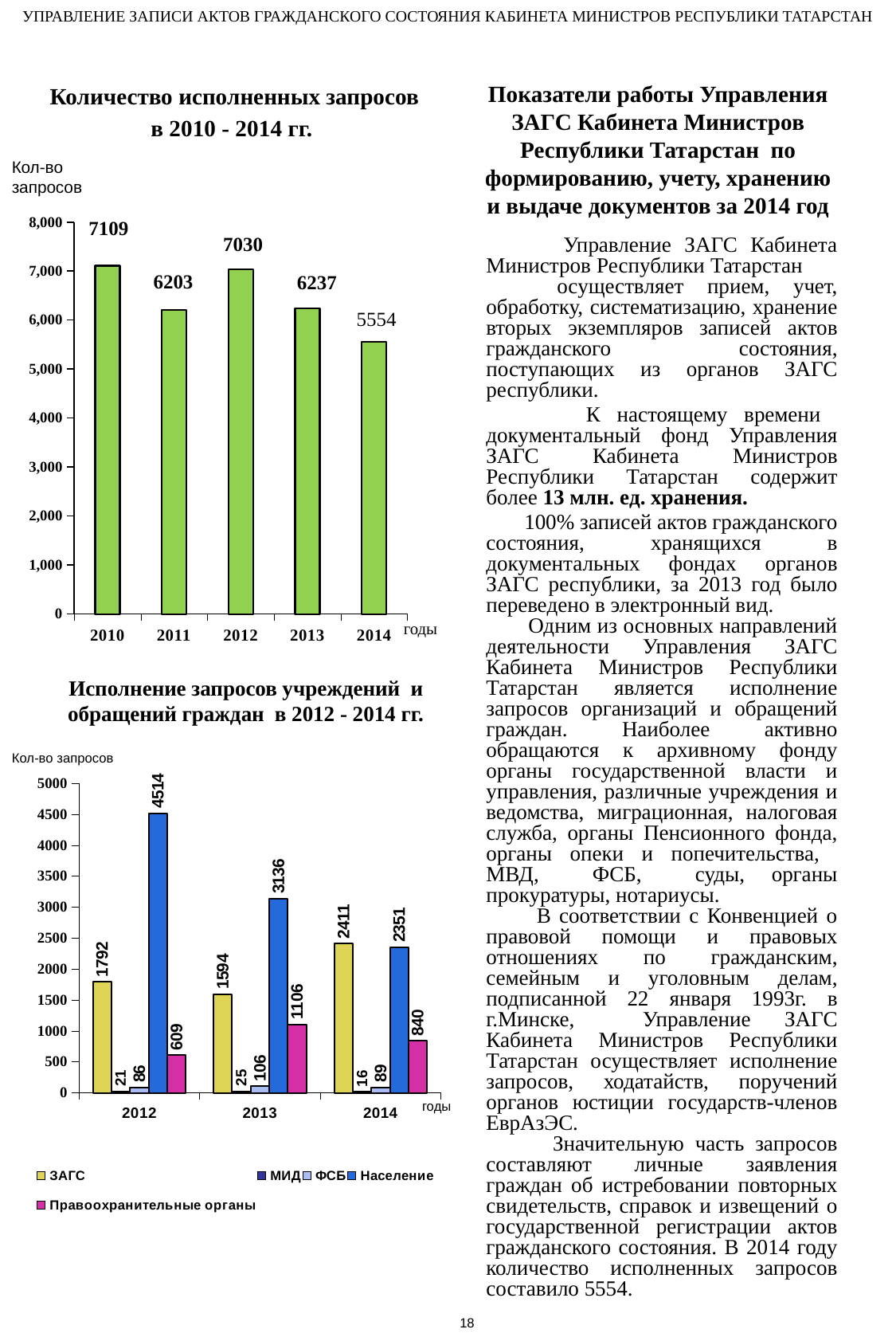
In the chart 'Исполнение запросов учреждений и обращений граждан в 2012 - 2014 гг.', what is the value for Население in 2013? 3136 In the chart 'Исполнение запросов учреждений и обращений граждан в 2012 - 2014 гг.', which is larger in 2014: ЗАГС or Население? ЗАГС In the chart 'Количество исполненных запросов в 2010 - 2014 гг.', what is the difference between the values for 2010 and 2014? 1555 In the chart 'Количество исполненных запросов в 2010 - 2014 гг.', how many years are shown? 5 In the chart 'Исполнение запросов учреждений и обращений граждан в 2012 - 2014 гг.', what is the value for Правоохранительные органы in 2014? 840 In the chart 'Количество исполненных запросов в 2010 - 2014 гг.', what is the value for 2012? 7030 What kind of chart is 'Количество исполненных запросов в 2010 - 2014 гг.'? bar chart In the chart 'Исполнение запросов учреждений и обращений граждан в 2012 - 2014 гг.', what is the difference between the Население values for 2012 and 2013? 1378 In the chart 'Исполнение запросов учреждений и обращений граждан в 2012 - 2014 гг.', do the values for Население rise or fall from 2012 to 2014? fall In the chart 'Количество исполненных запросов в 2010 - 2014 гг.', which year has the highest value? 2010 In the chart 'Исполнение запросов учреждений и обращений граждан в 2012 - 2014 гг.', how many series does the legend list? 5 In the chart 'Количество исполненных запросов в 2010 - 2014 гг.', which year has the lowest value? 2014